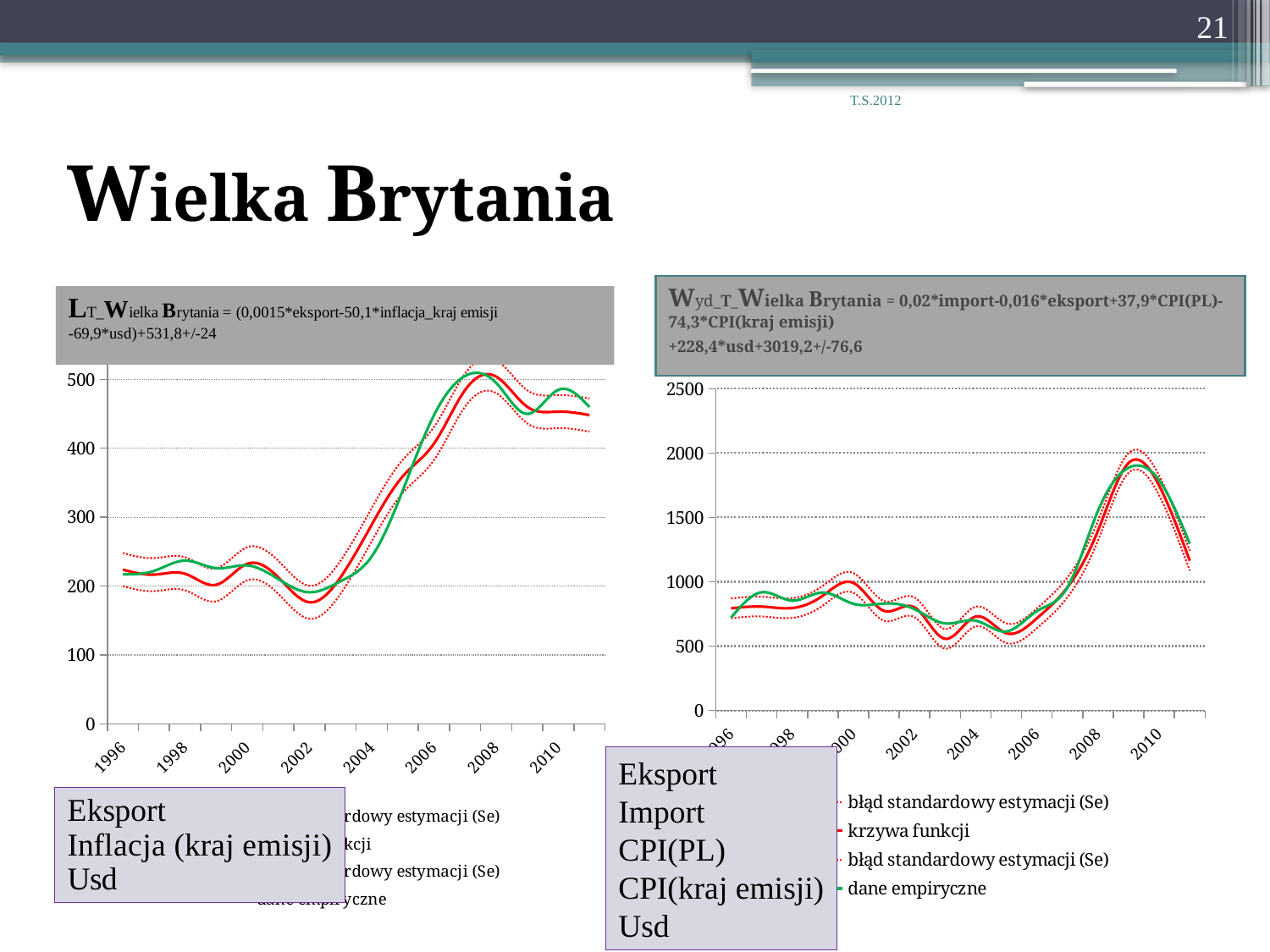
In the right chart, is the peak value of the empirical data (green line) around 2009 greater or less than 1500? greater In the left chart, is the value of the empirical data (green line) in 1998 greater or less than 300? less In the right chart, does the empirical data (green line) rise or fall between 2006 and 2009? rise What kind of chart is the right chart (Wyd_T_Wielka Brytania)? line chart In the right chart's legend, what colour is the line for 'dane empiryczne'? green What kind of chart is the left chart (LT_Wielka Brytania)? line chart In the left chart, is the value of the empirical data (green line) in 2008 greater or less than 400? greater How many year labels are shown on the x axis of the left chart? 8 In the left chart, does the empirical data (green line) rise or fall between 2002 and 2008? rise How many entries does the legend of the right chart list? 4 In the left chart, around which labelled year does the empirical data (green line) reach its highest value? 2008